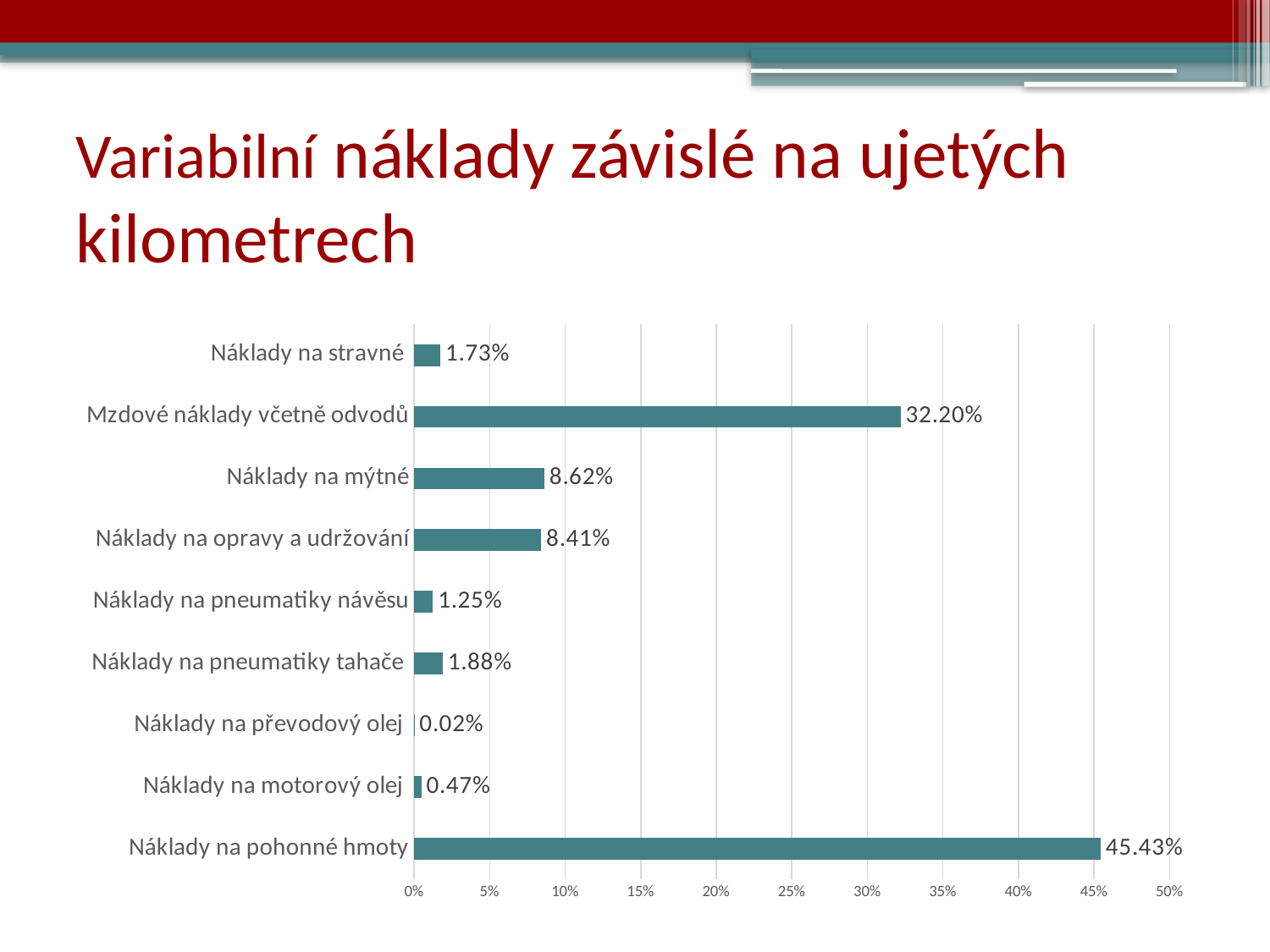
What is the value for Náklady na pohonné hmoty? 45.43% What is the value for Mzdové náklady včetně odvodů? 32.20% Which category has the lowest value? Náklady na převodový olej Is the value for Mzdové náklady včetně odvodů greater or less than 30%? greater Which category has the highest value? Náklady na pohonné hmoty What is the value for Náklady na převodový olej? 0.02% Which is larger, Náklady na pneumatiky tahače or Náklady na pneumatiky návěsu? Náklady na pneumatiky tahače What kind of chart is shown on the slide? bar chart How many categories are shown in the chart? 9 What is the value for Náklady na mýtné? 8.62% What is the title of the slide containing the chart? Variabilní náklady závislé na ujetých kilometrech What is the difference between Náklady na pohonné hmoty and Mzdové náklady včetně odvodů? 13.23%